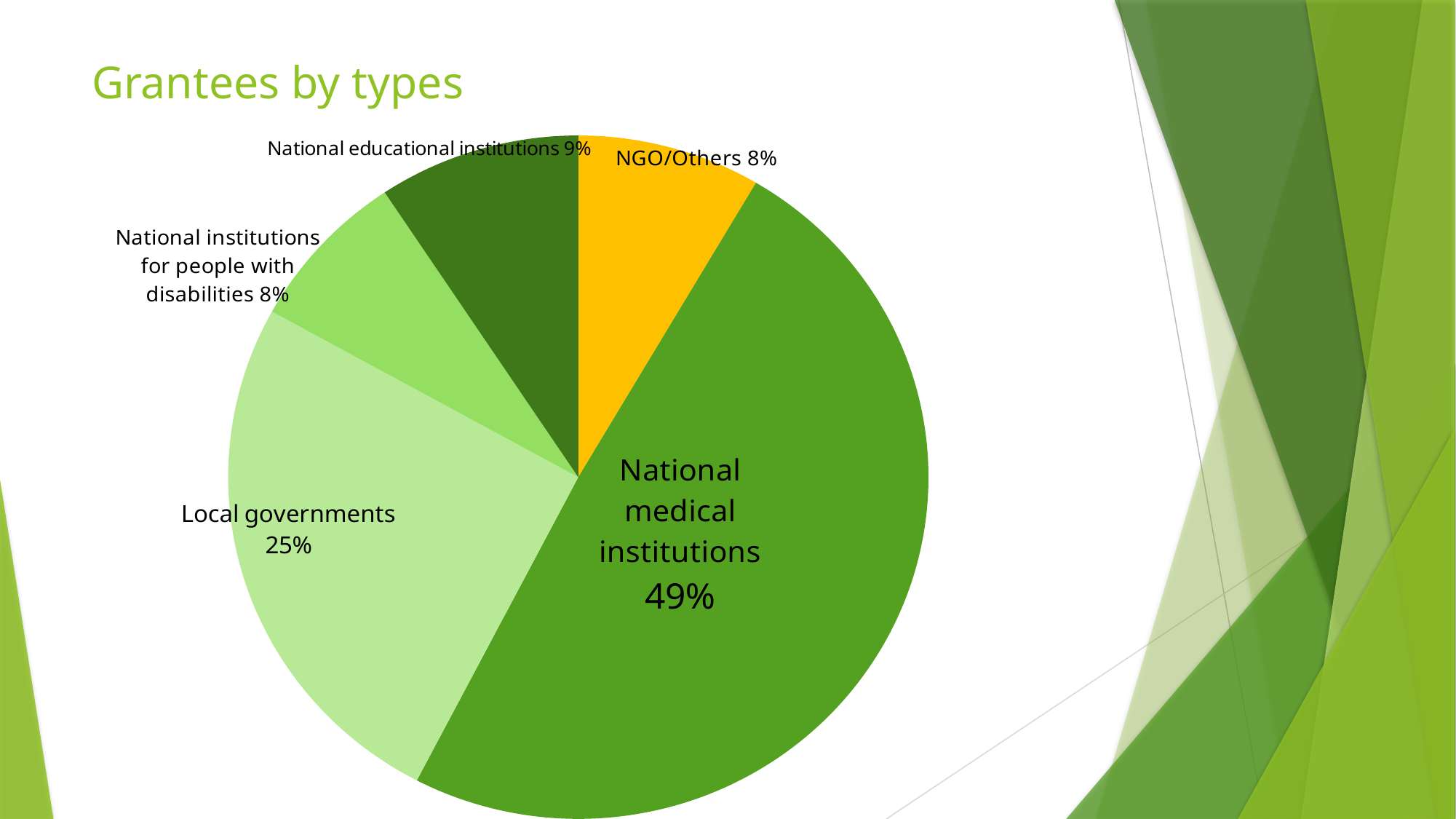
Which grantee type has the largest share? National medical institutions What kind of chart is shown on the slide? pie chart What colour is the NGO/Others slice? yellow What share of grantees are NGO/Others? 8% What share of grantees are National institutions for people with disabilities? 8% What share of grantees are National medical institutions? 49% How many grantee types (slices) are shown in the pie chart? 5 Which is larger, the share for Local governments or the share for National educational institutions? Local governments What is the title of the chart? Grantees by types What is the difference in percentage points between National medical institutions and Local governments? 24 What share of grantees are Local governments? 25% What share of grantees are National educational institutions? 9%